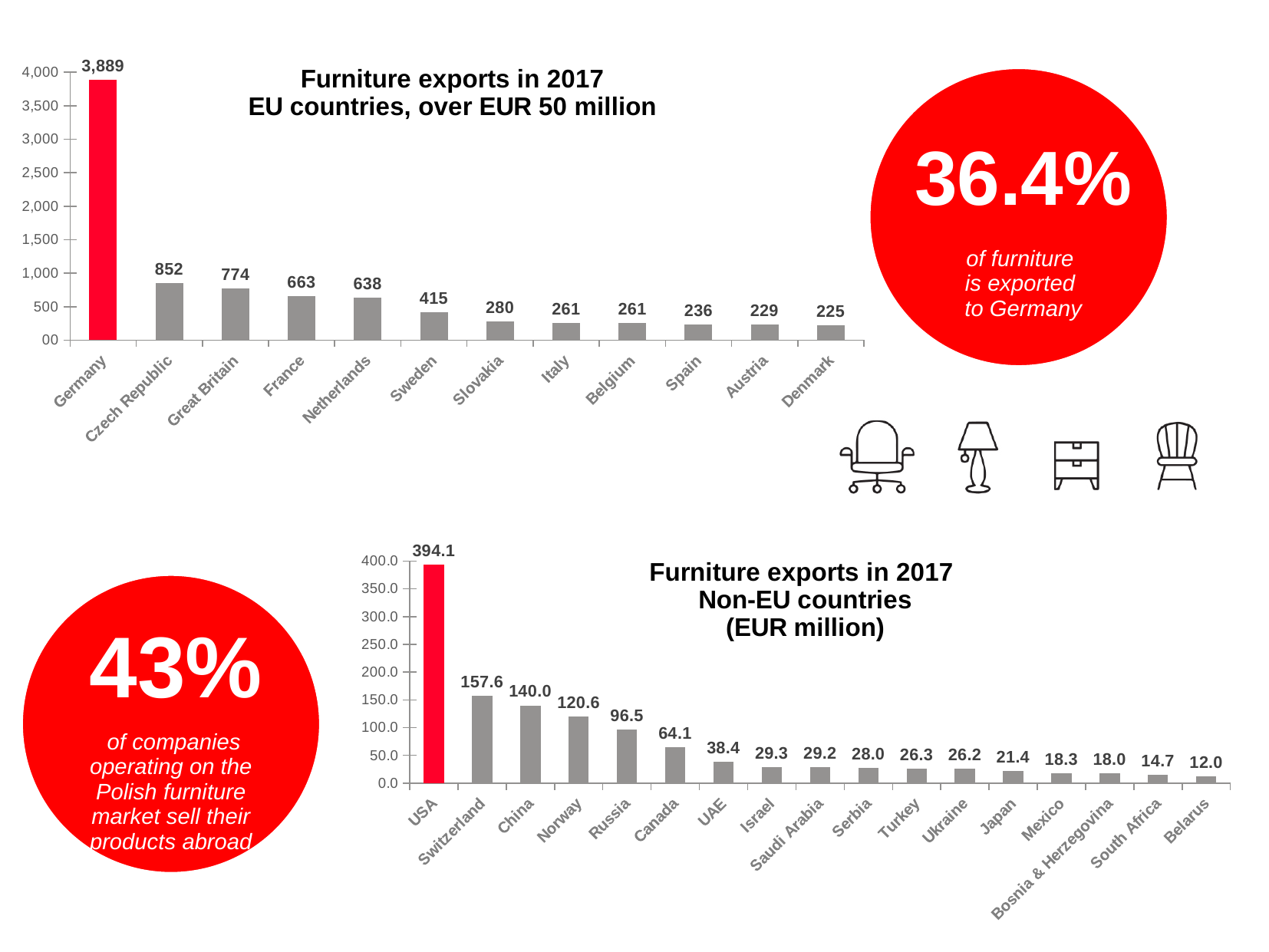
In the 'Furniture exports in 2017 Non-EU countries (EUR million)' chart, what is the value for USA? 394.1 What type of chart is the 'Furniture exports in 2017 Non-EU countries (EUR million)' chart? Bar chart In the 'Furniture exports in 2017 Non-EU countries (EUR million)' chart, which country has the highest value? USA In the 'Furniture exports in 2017 EU countries, over EUR 50 million' chart, which is larger, France or Sweden? France In the 'Furniture exports in 2017 EU countries, over EUR 50 million' chart, what is the value for Netherlands? 638 In the 'Furniture exports in 2017 EU countries, over EUR 50 million' chart, what is the difference between Czech Republic and Great Britain? 78 In the 'Furniture exports in 2017 Non-EU countries (EUR million)' chart, what is the value for Bosnia & Herzegovina? 18.0 In the 'Furniture exports in 2017 EU countries, over EUR 50 million' chart, which country has the lowest value? Denmark In the 'Furniture exports in 2017 Non-EU countries (EUR million)' chart, how many countries are shown? 17 In the 'Furniture exports in 2017 EU countries, over EUR 50 million' chart, how many countries are shown? 12 In the 'Furniture exports in 2017 Non-EU countries (EUR million)' chart, what is the difference between Switzerland and China? 17.6 In the 'Furniture exports in 2017 EU countries, over EUR 50 million' chart, what is the value for Germany? 3,889